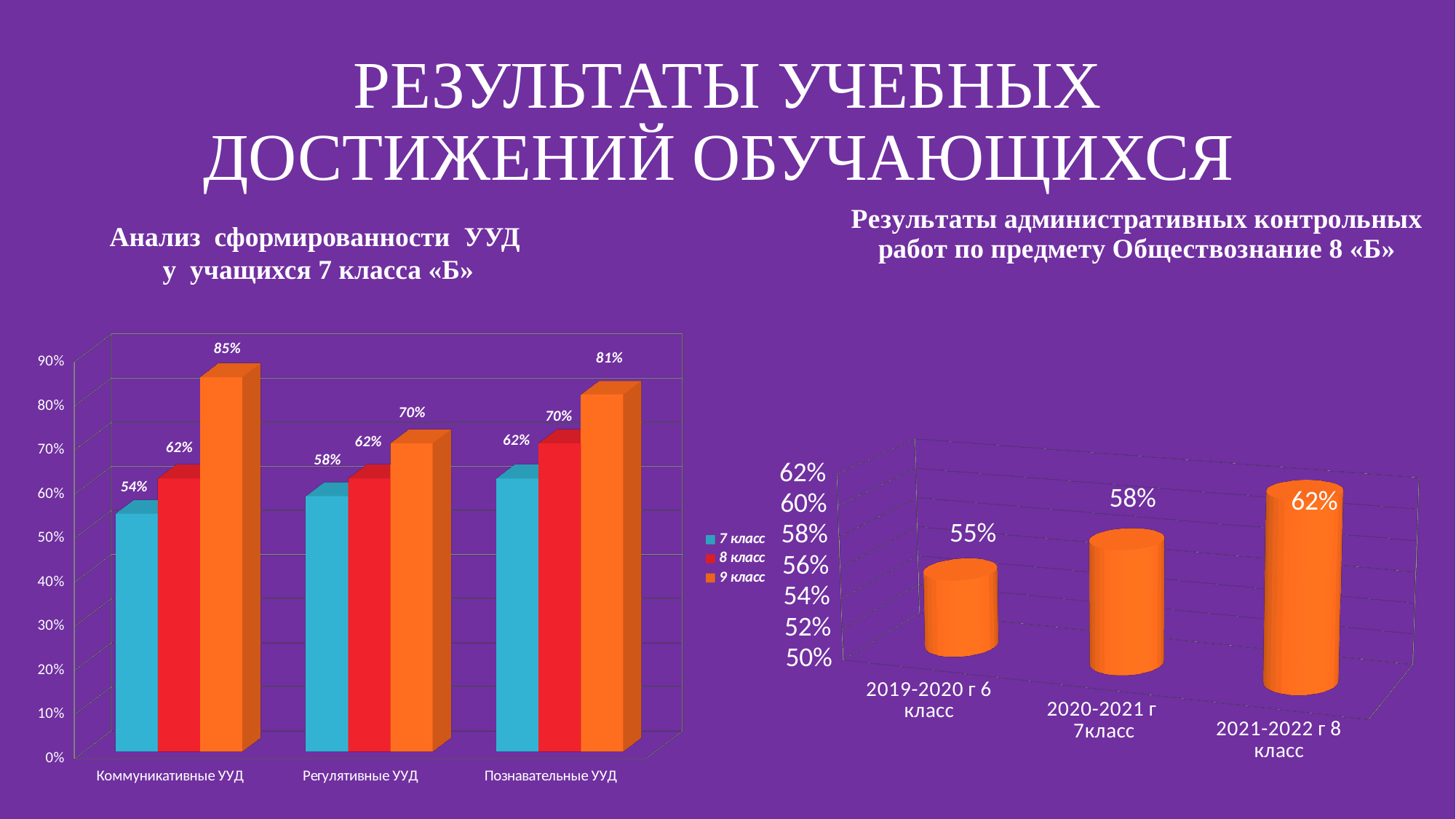
In the left chart (Анализ сформированности УУД), which category has the lowest value for 7 класс? Коммуникативные УУД In the left chart (Анализ сформированности УУД), what is the difference between the 9 класс and 7 класс values for Коммуникативные УУД? 31% In the left chart (Анализ сформированности УУД), what is the value for 8 класс in Познавательные УУД? 70% In the left chart (Анализ сформированности УУД), how many series does the legend list? 3 In the right chart (Результаты административных контрольных работ), which category has the highest value? 2021-2022 г 8 класс In the right chart (Результаты административных контрольных работ), what is the value for 2020-2021 г 7класс? 58% In the right chart (Результаты административных контрольных работ), what is the difference between the 2021-2022 г 8 класс value and the 2019-2020 г 6 класс value? 7% In the right chart (Результаты административных контрольных работ), do the values rise or fall from left to right? rise In the left chart (Анализ сформированности УУД), what is the value for 9 класс in Коммуникативные УУД? 85% In the left chart (Анализ сформированности УУД), what is the value for 7 класс in Регулятивные УУД? 58% In the right chart (Результаты административных контрольных работ), how many categories are shown? 3 In the left chart (Анализ сформированности УУД), which is larger: the 9 класс value for Регулятивные УУД or the 9 класс value for Познавательные УУД? Познавательные УУД